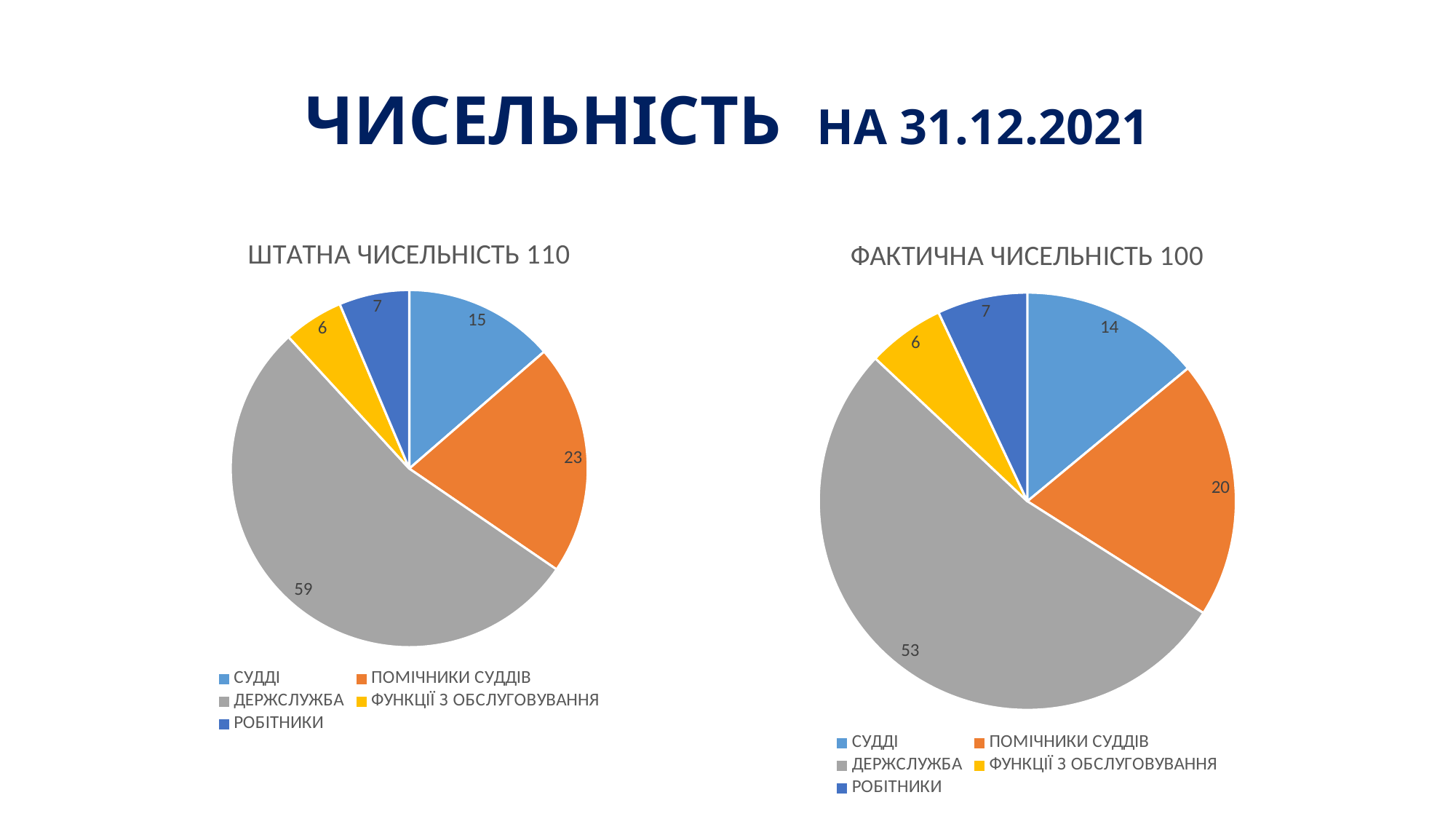
In the 'ФАКТИЧНА ЧИСЕЛЬНІСТЬ 100' chart, what is the value for СУДДІ? 14 In the 'ШТАТНА ЧИСЕЛЬНІСТЬ 110' chart, what is the value for ДЕРЖСЛУЖБА? 59 In the 'ШТАТНА ЧИСЕЛЬНІСТЬ 110' chart, what colour is the ФУНКЦІЇ З ОБСЛУГОВУВАННЯ slice? yellow In the 'ФАКТИЧНА ЧИСЕЛЬНІСТЬ 100' chart, which category has the smallest slice? ФУНКЦІЇ З ОБСЛУГОВУВАННЯ How many slices does the 'ФАКТИЧНА ЧИСЕЛЬНІСТЬ 100' chart have? 5 In the 'ШТАТНА ЧИСЕЛЬНІСТЬ 110' chart, which category has the largest slice? ДЕРЖСЛУЖБА What is the difference between the ДЕРЖСЛУЖБА value in the 'ШТАТНА ЧИСЕЛЬНІСТЬ 110' chart and the ДЕРЖСЛУЖБА value in the 'ФАКТИЧНА ЧИСЕЛЬНІСТЬ 100' chart? 6 In the 'ФАКТИЧНА ЧИСЕЛЬНІСТЬ 100' chart, what is the value for РОБІТНИКИ? 7 In the 'ШТАТНА ЧИСЕЛЬНІСТЬ 110' chart, which is larger: СУДДІ or ПОМІЧНИКИ СУДДІВ? ПОМІЧНИКИ СУДДІВ What kind of chart is the 'ШТАТНА ЧИСЕЛЬНІСТЬ 110' chart on the left? pie chart In the 'ШТАТНА ЧИСЕЛЬНІСТЬ 110' chart, what is the value for ПОМІЧНИКИ СУДДІВ? 23 In the 'ФАКТИЧНА ЧИСЕЛЬНІСТЬ 100' chart, what share of the total does ДЕРЖСЛУЖБА represent? 53%